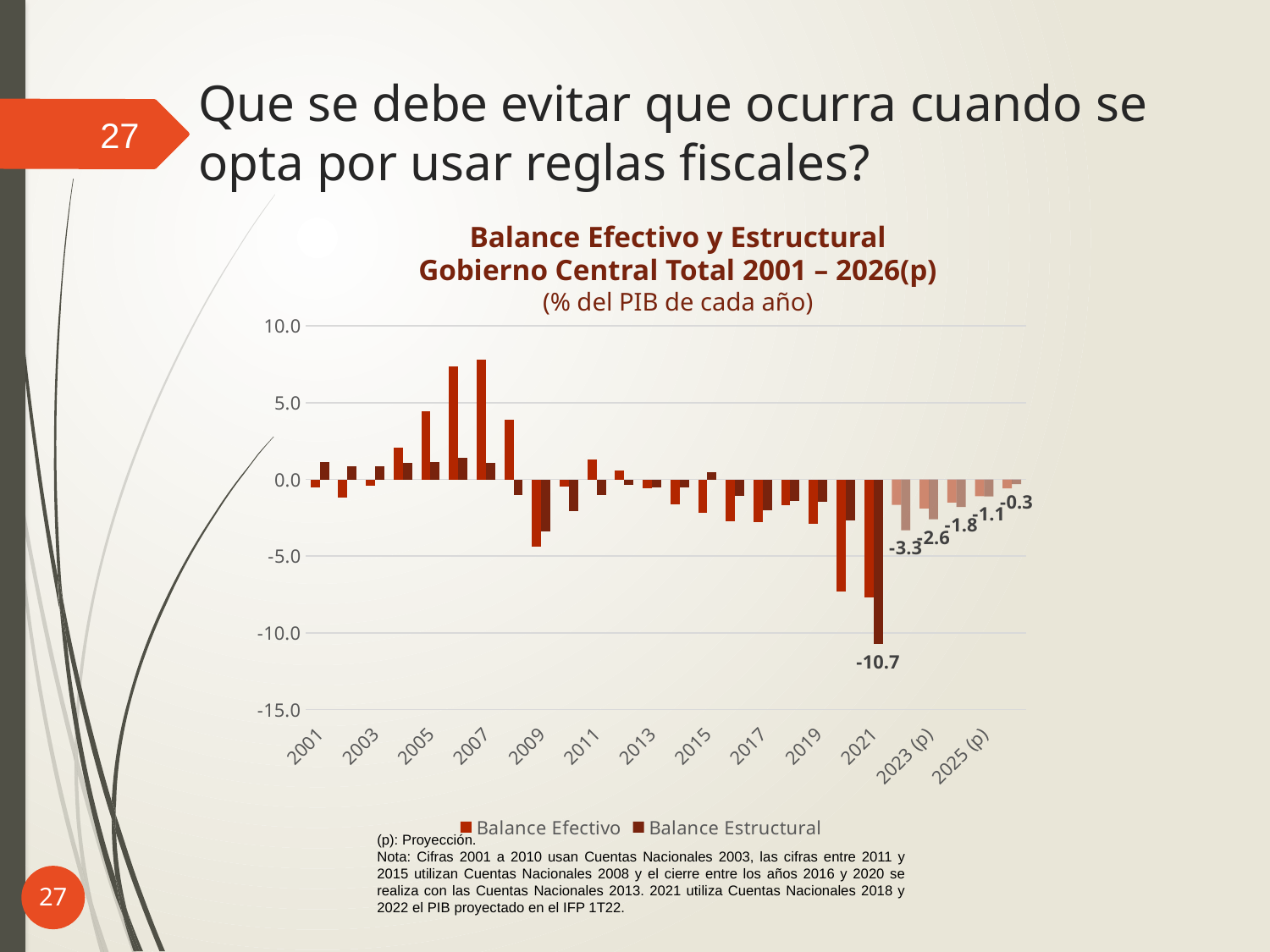
In what unit are the values expressed, according to the chart subtitle? % del PIB de cada año Is the value of the lowest bar greater or less than -10.0? less What is the rightmost data label printed on the chart? -0.3 How many data labels are printed on the chart? 6 What is the value printed on the lowest bar in the chart? -10.7 Which year has the lowest bar in the chart? 2021 Is the tallest positive bar (around 2007) greater or less than 5.0? greater What kind of chart is shown on the slide? bar chart Do the five labeled projection values (-3.3 to -0.3) rise or fall from left to right? rise How many series does the legend list? 2 What is the difference between the labeled values -0.3 and -3.3? 3.0 What are the two series named in the legend? Balance Efectivo and Balance Estructural